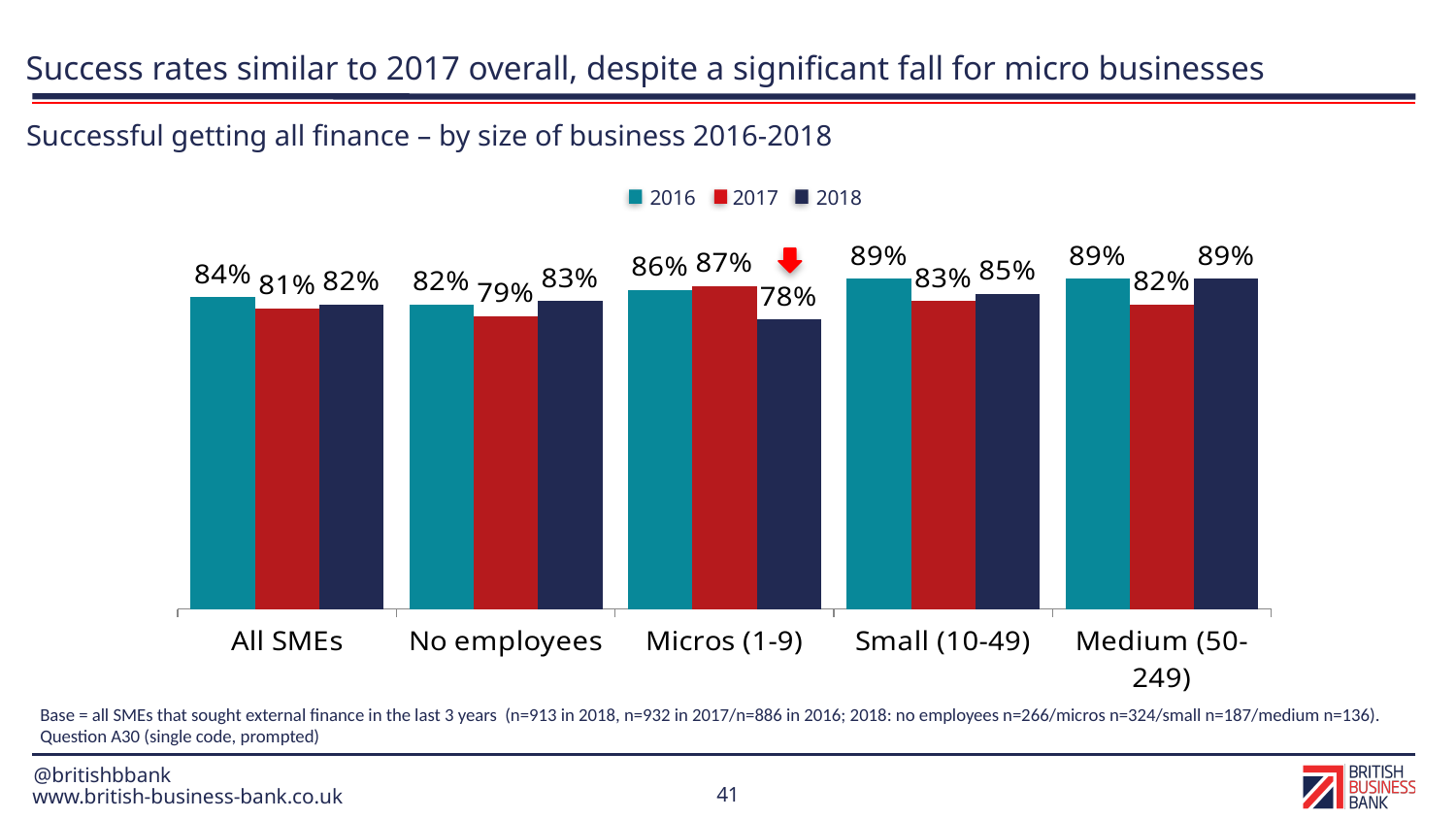
How many series does the legend list? 3 Which years are listed in the chart legend? 2016, 2017, 2018 What kind of chart is shown on the slide? Bar chart What was the success rate for Micros (1-9) in 2018? 78% Which business size category had the lowest success rate in 2018? Micros (1-9) What is the difference between the 2016 and 2017 success rates for Medium (50-249)? 7 percentage points Which business size category had the highest success rate in 2018? Medium (50-249) What is the difference between the 2017 and 2018 success rates for Micros (1-9)? 9 percentage points What was the success rate for All SMEs in 2016? 84% How many business size categories are shown on the x axis? 5 What was the success rate for Small (10-49) in 2017? 83% Which is larger: the 2016 success rate for No employees or the 2018 success rate for No employees? 2018 (83%)